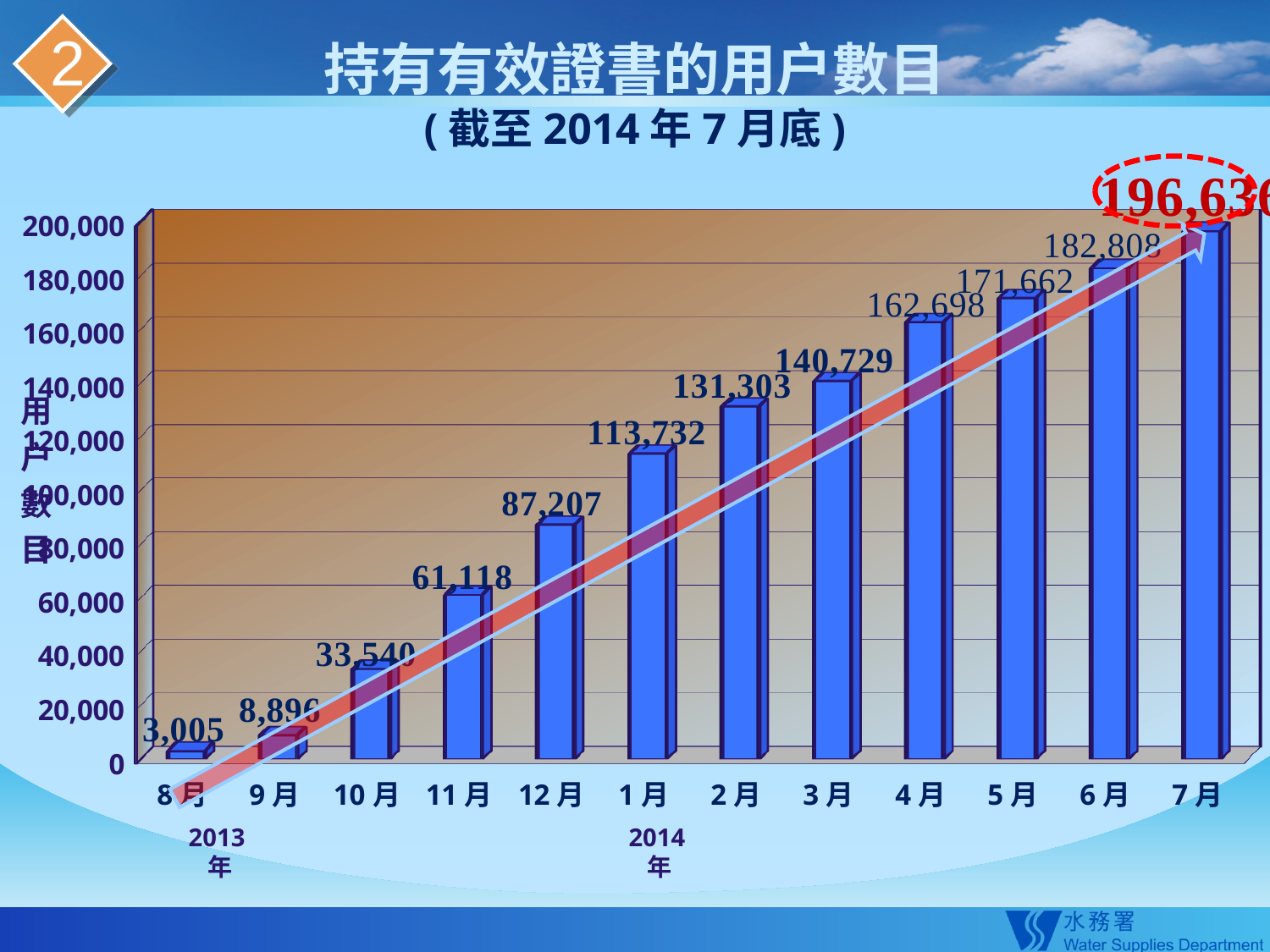
What is the value for 1月 (2014)? 113,732 Do the values rise or fall from 8月 2013 to 7月 2014? rise How many months are plotted on the chart? 12 Which month has the highest value? 7月 What is the value for 4月? 162,698 Which month has the lowest value? 8月 What type of chart is shown on the slide? bar chart Is the value for 6月 greater or less than 180,000? greater What is the value for 10月? 33,540 What is the value for 8月 (2013)? 3,005 What is the difference between the values for 12月 and 11月? 26,089 Which is larger, the value for 2月 or the value for 3月? 3月